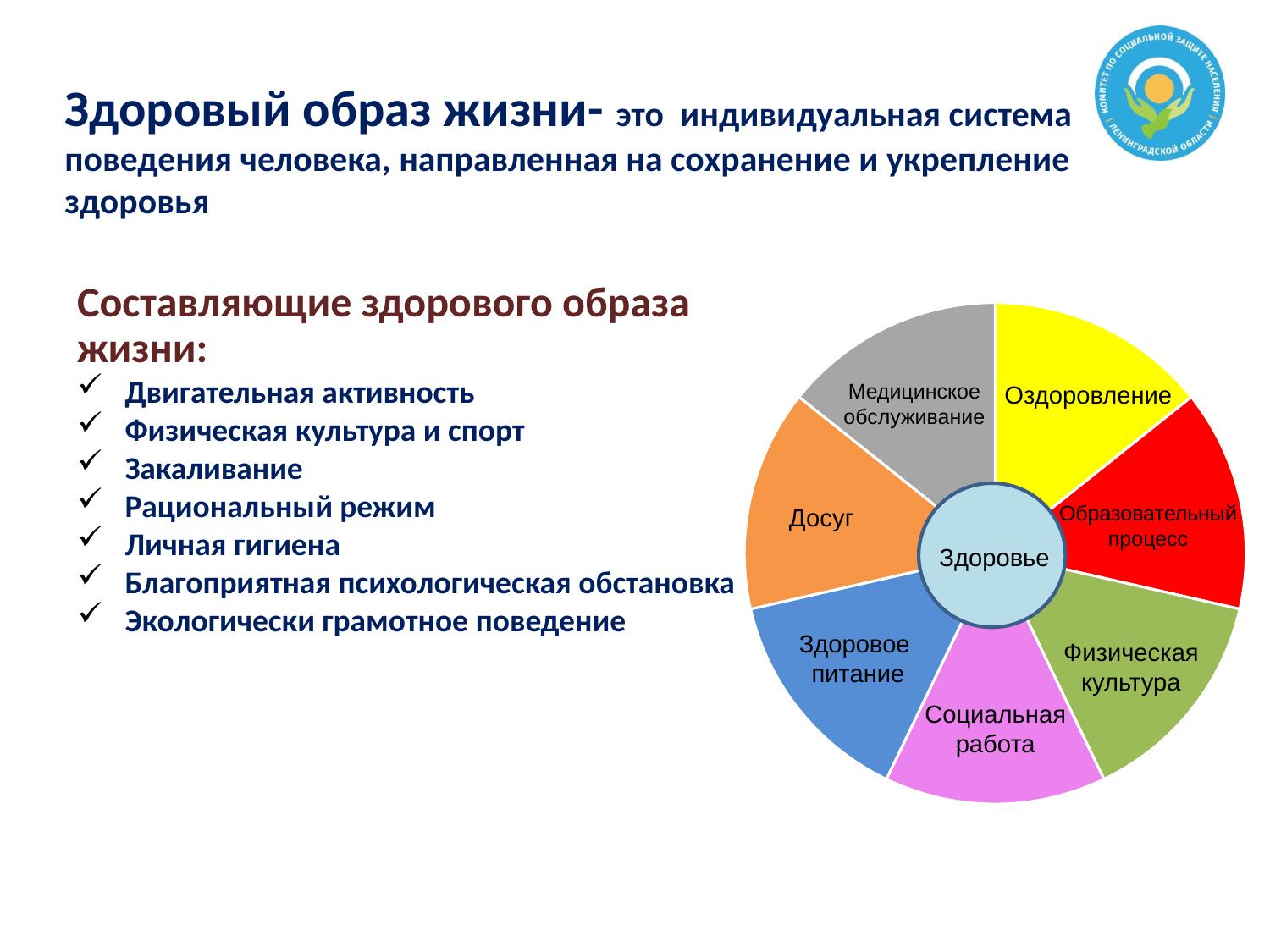
Which segment of the pie chart is coloured grey? Медицинское обслуживание Which segment of the pie chart is coloured blue? Здоровое питание Which segment of the pie chart is coloured orange? Досуг Which segment of the pie chart is coloured pink? Социальная работа What label is written in the centre circle of the pie chart? Здоровье Which segment of the pie chart is coloured green? Физическая культура Which segment of the pie chart is coloured red? Образовательный процесс What kind of chart is shown on the right side of the slide? pie chart Which segment of the pie chart is coloured yellow? Оздоровление How many segments does the pie chart on the slide have? 7